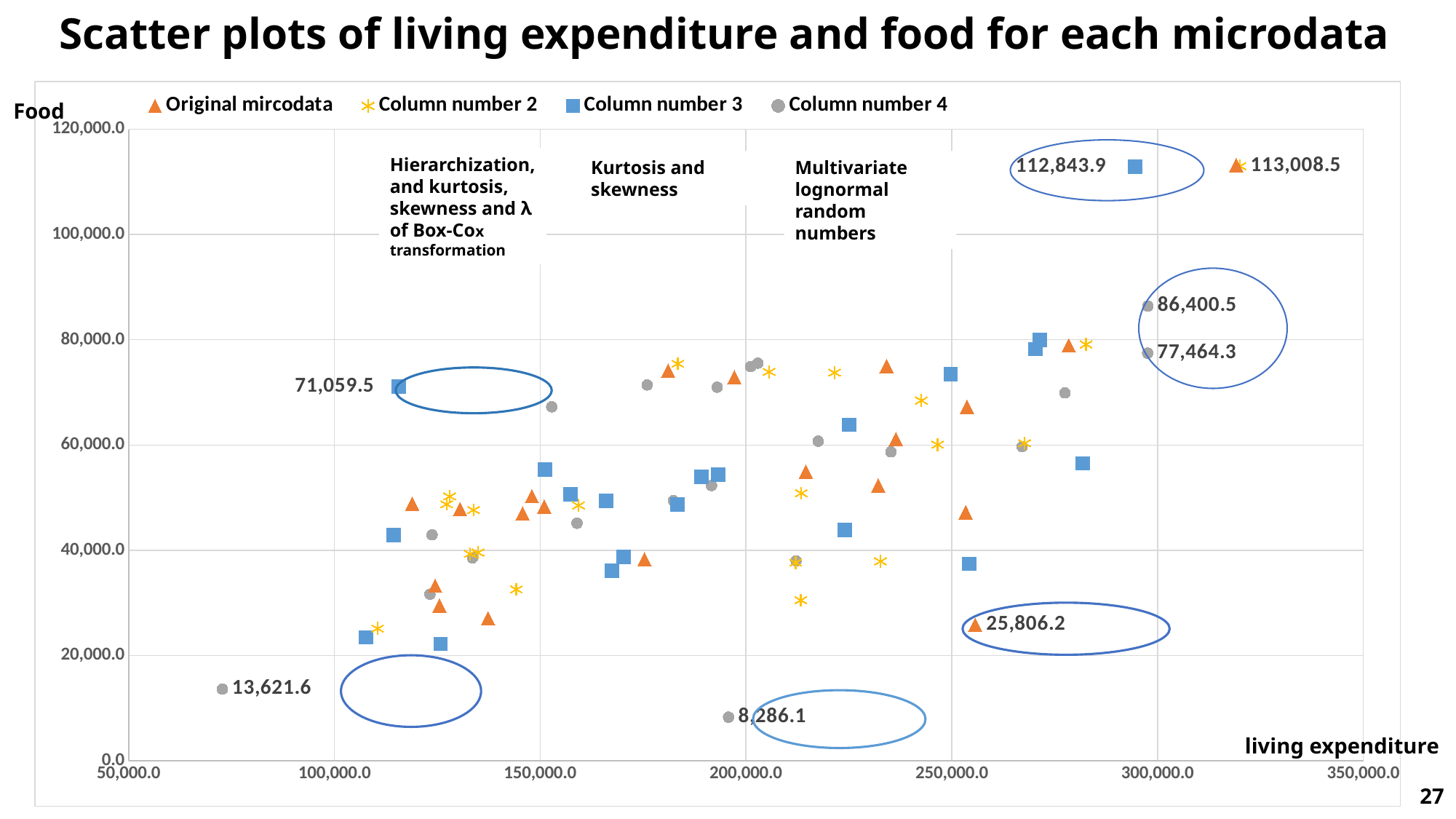
What is the Food value of the labelled Original microdata point circled near 255,000 living expenditure? 25,806.2 How many series does the legend list? 4 What is the Food value of the labelled Column number 3 point near 115,000 living expenditure? 71,059.5 What is the label of the vertical axis? Food What kind of chart is shown on the slide? Scatter plot Which is larger: the labelled Original microdata point at 113,008.5 or the labelled Column number 3 point at 112,843.9? 113,008.5 What is the difference between the two labelled Column number 4 points circled at the right, 86,400.5 and 77,464.3? 8,936.2 What is the label of the horizontal axis? living expenditure What is the Food value of the labelled Column number 3 point circled at the top of the chart? 112,843.9 What is the lowest labelled Food value on the chart? 8,286.1 Is the Food value of the labelled Column number 4 point at 13,621.6 greater or less than 20,000.0? less